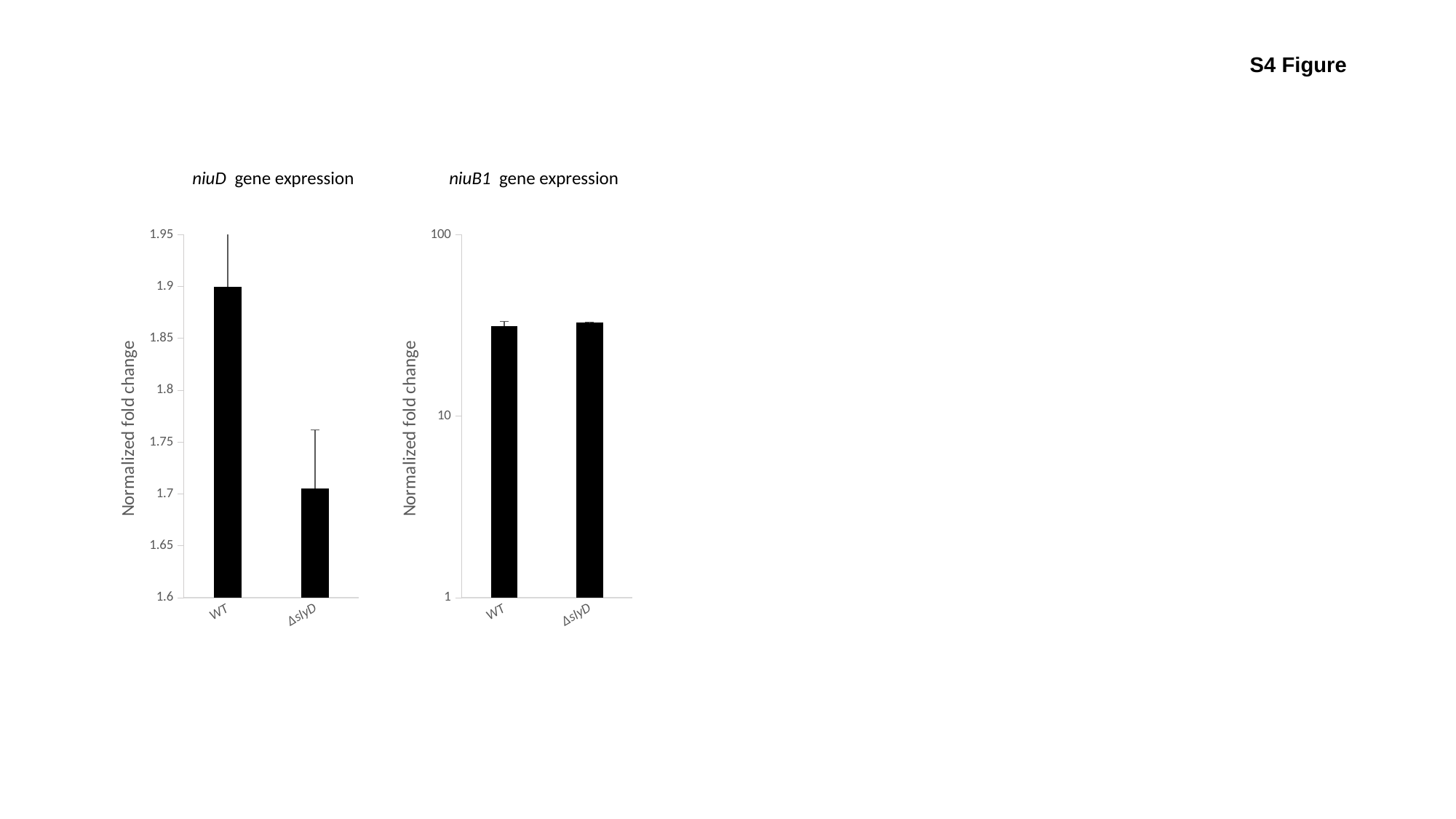
In the niuB1 gene expression chart, is the value for ΔslyD greater or less than 100? less How many bars are plotted in the niuB1 gene expression chart? 2 In the niuD gene expression chart, is the value for WT greater or less than 1.85? greater In the niuD gene expression chart, is the value for ΔslyD greater or less than 1.75? less In the niuD gene expression chart, which is larger, the value for WT or the value for ΔslyD? WT What kind of chart is the niuD gene expression chart? bar chart In the niuD gene expression chart, which category has the lowest normalized fold change? ΔslyD What is the y-axis label of the niuB1 gene expression chart? Normalized fold change What is the title of the chart on the left of the slide? niuD gene expression In the niuD gene expression chart, which category has the highest normalized fold change? WT How many categories are shown on the x axis of the niuD gene expression chart? 2